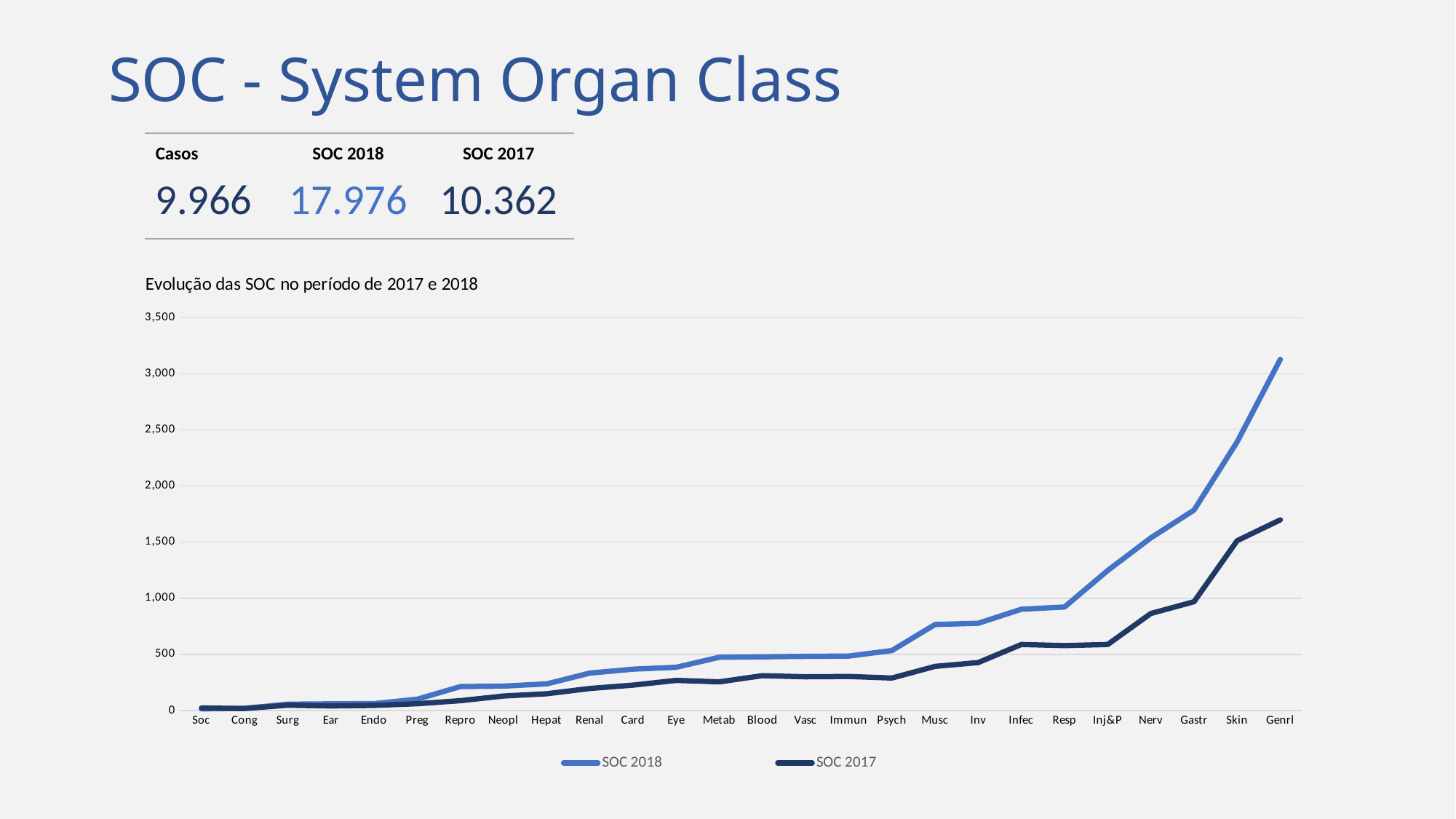
Is the SOC 2017 value for Genrl greater or less than 2,000? less Do the values of the SOC 2018 series generally rise or fall from left to right along the x axis? rise What is the title of the chart? Evolução das SOC no período de 2017 e 2018 How many series does the chart legend list? 2 Is the SOC 2017 value for Nerv greater or less than 1,000? less Which category has the highest value for the SOC 2017 series? Genrl How many categories are plotted along the x axis of the chart? 26 What kind of chart is shown on the slide? line chart At Skin, which series has the larger value, SOC 2018 or SOC 2017? SOC 2018 Which category has the highest value for the SOC 2018 series? Genrl Is the SOC 2018 value for Genrl greater or less than 2,500? greater